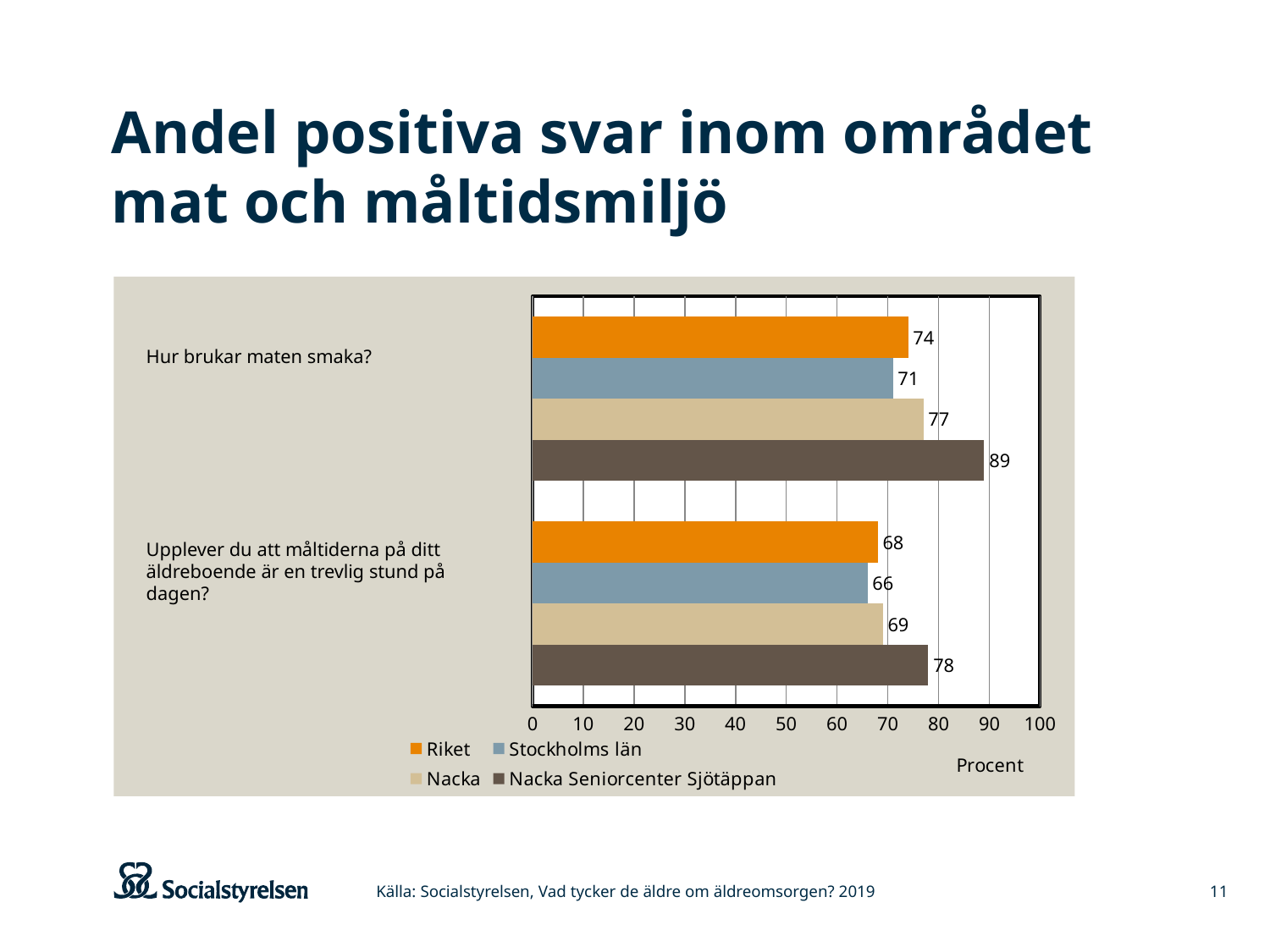
Which is larger: the Nacka value for "Hur brukar maten smaka?" or the Nacka value for "Upplever du att måltiderna på ditt äldreboende är en trevlig stund på dagen?"? Hur brukar maten smaka? What kind of chart is shown on the slide? Bar chart What unit is shown on the x axis of the chart? Procent How many series does the legend list? 4 What is the difference between Nacka and Stockholms län for "Upplever du att måltiderna på ditt äldreboende är en trevlig stund på dagen?"? 3 Which series has the lowest value for "Upplever du att måltiderna på ditt äldreboende är en trevlig stund på dagen?"? Stockholms län What is the value for Stockholms län for "Upplever du att måltiderna på ditt äldreboende är en trevlig stund på dagen?"? 66 Is the value for Nacka Seniorcenter Sjötäppan for "Upplever du att måltiderna på ditt äldreboende är en trevlig stund på dagen?" greater or less than 70? greater Which series has the highest value for "Hur brukar maten smaka?"? Nacka Seniorcenter Sjötäppan What is the value for Riket for "Hur brukar maten smaka?"? 74 What is the value for Nacka Seniorcenter Sjötäppan for "Hur brukar maten smaka?"? 89 What is the difference between Nacka Seniorcenter Sjötäppan and Riket for "Hur brukar maten smaka?"? 15